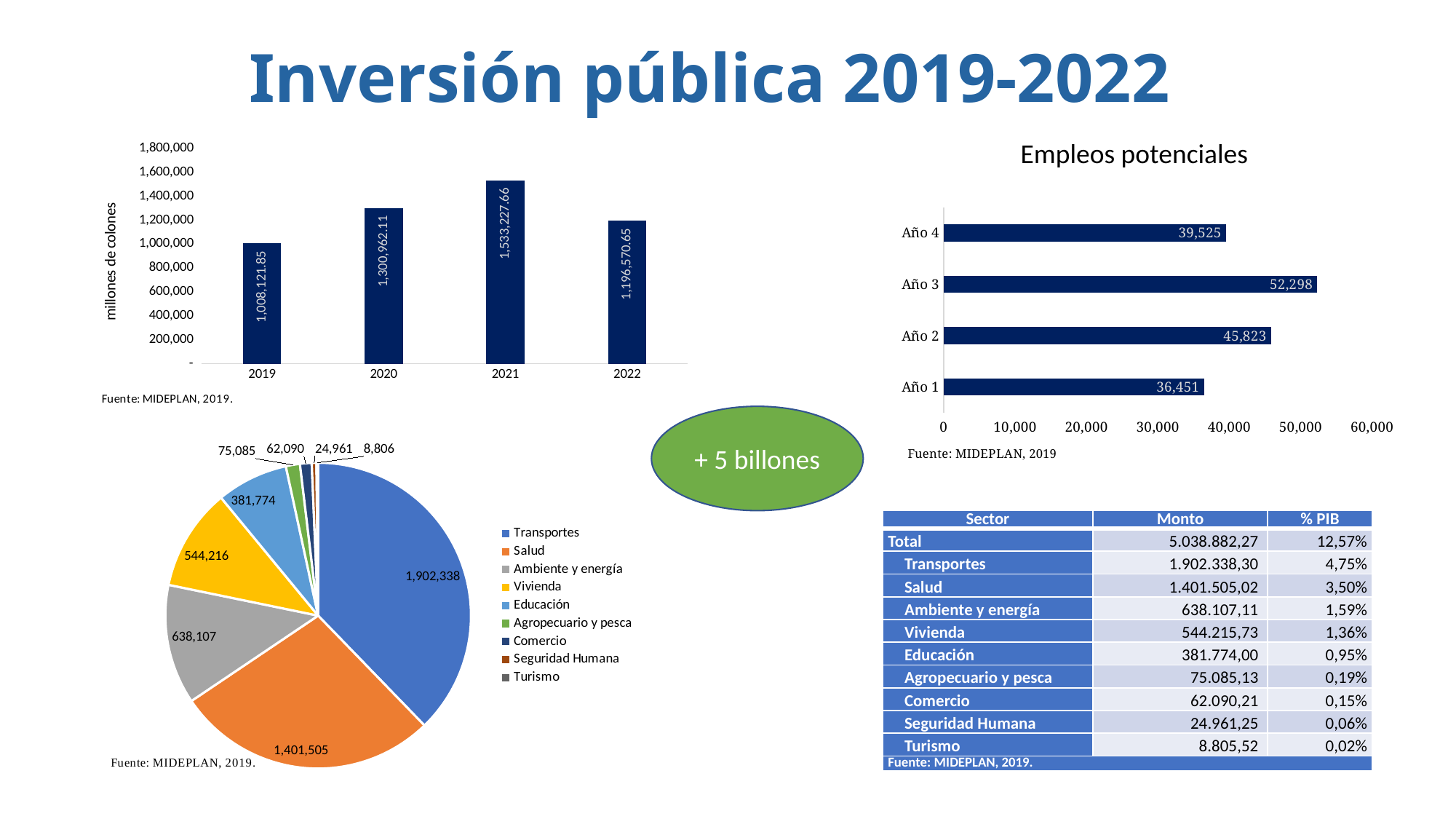
In the top-left bar chart of investment in millions of colones, which year has the lowest value? 2019 In the top-left bar chart of investment in millions of colones, what is the difference between the 2021 and 2019 values? 525,105.81 In the 'Empleos potenciales' chart, what is the difference between Año 3 and Año 1? 15,847 In the bottom-left pie chart, how many sectors does the legend list? 9 In the bottom-left pie chart, what is the value for Vivienda? 544,216 In the 'Empleos potenciales' chart, which year has the highest value? Año 3 In the top-left bar chart of investment in millions of colones, how many years are plotted? 4 In the top-left bar chart of investment in millions of colones, which year has the highest value? 2021 In the top-left bar chart of investment in millions of colones, what is the value for 2021? 1,533,227.66 In the bottom-left pie chart, which sector has the smallest slice? Turismo In the 'Empleos potenciales' chart, what is the value for Año 2? 45,823 What kind of chart is the 'Empleos potenciales' chart? bar chart